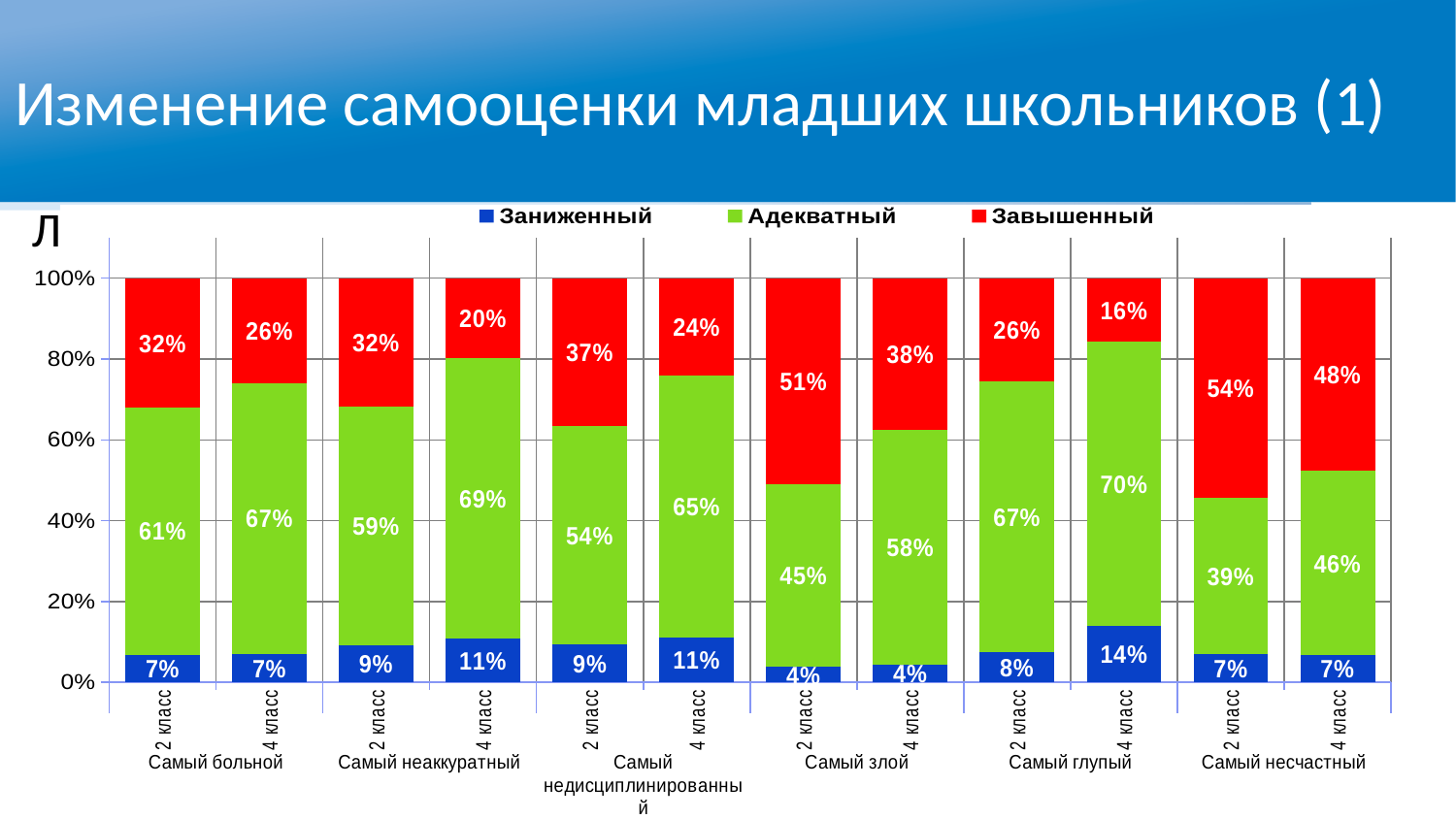
Which bar has the lowest Адекватный value? Самый несчастный, 2 класс What is the difference between the Завышенный values for Самый злой, 2 класс and Самый злой, 4 класс? 13% What is the value of Завышенный for Самый несчастный, 2 класс? 54% Which bar has the highest Заниженный value? Самый глупый, 4 класс Which is larger: the Адекватный value for Самый больной, 4 класс or for Самый неаккуратный, 4 класс? Самый неаккуратный, 4 класс What kind of chart is shown on the slide? Stacked bar chart How many bars are plotted in the chart? 12 What is the value of Заниженный for Самый злой, 4 класс? 4% What is the value of Адекватный for Самый глупый, 4 класс? 70% Which series is shown in red in the legend? Завышенный What is the total of the stacked bar for Самый недисциплинированный, 2 класс? 100% How many series does the legend list? 3